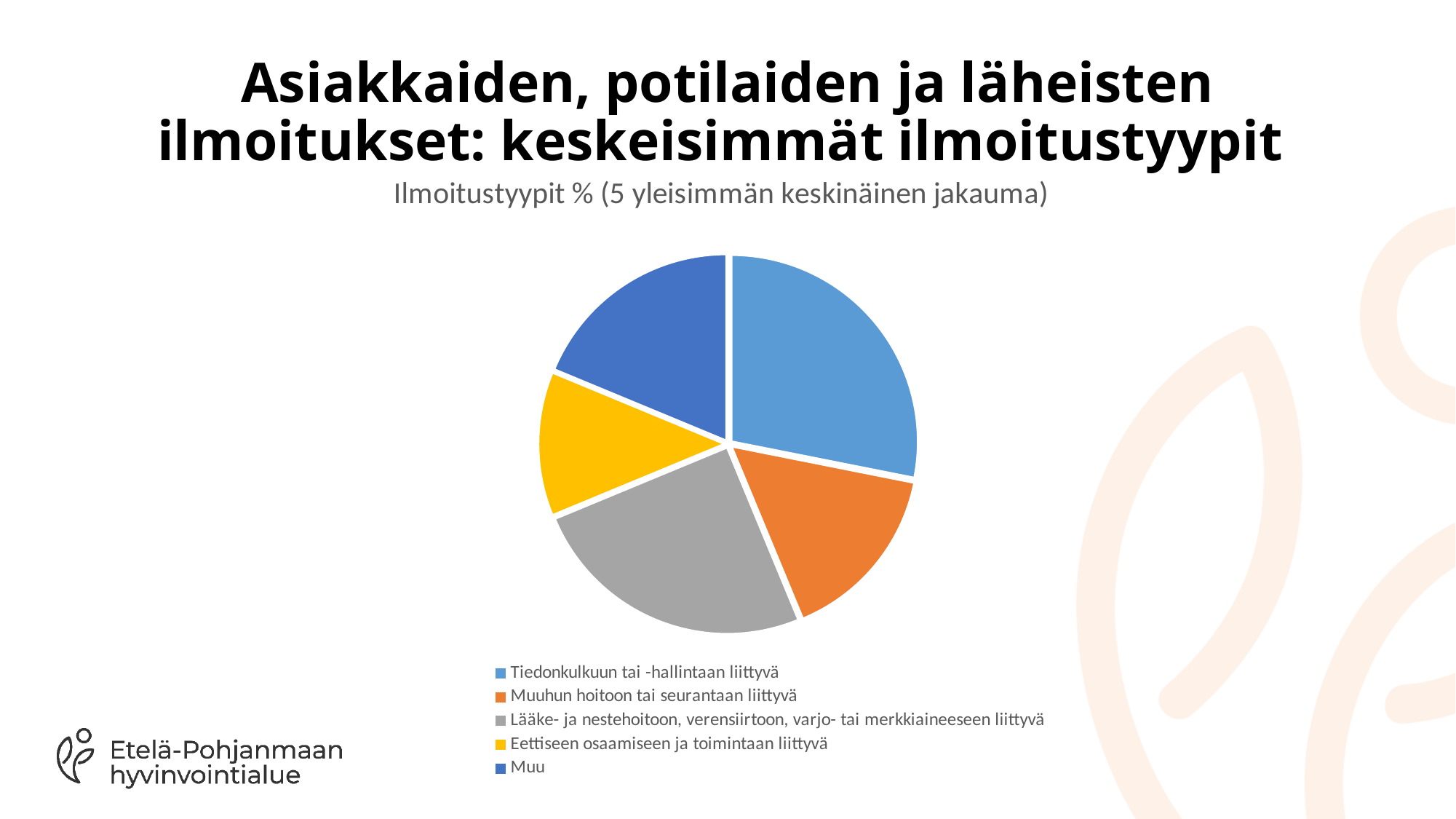
Which legend entry is shown in yellow? Eettiseen osaamiseen ja toimintaan liittyvä Which slice is larger: "Tiedonkulkuun tai -hallintaan liittyvä" or "Muu"? Tiedonkulkuun tai -hallintaan liittyvä Which slice is larger: "Lääke- ja nestehoitoon, verensiirtoon, varjo- tai merkkiaineeseen liittyvä" or "Eettiseen osaamiseen ja toimintaan liittyvä"? Lääke- ja nestehoitoon, verensiirtoon, varjo- tai merkkiaineeseen liittyvä How many entries does the legend of the pie chart list? 5 Which slice is larger: "Tiedonkulkuun tai -hallintaan liittyvä" or "Muuhun hoitoon tai seurantaan liittyvä"? Tiedonkulkuun tai -hallintaan liittyvä What is the title of the pie chart? Ilmoitustyypit % (5 yleisimmän keskinäinen jakauma) How many slices does the pie chart have? 5 What kind of chart is shown on the slide? Pie chart